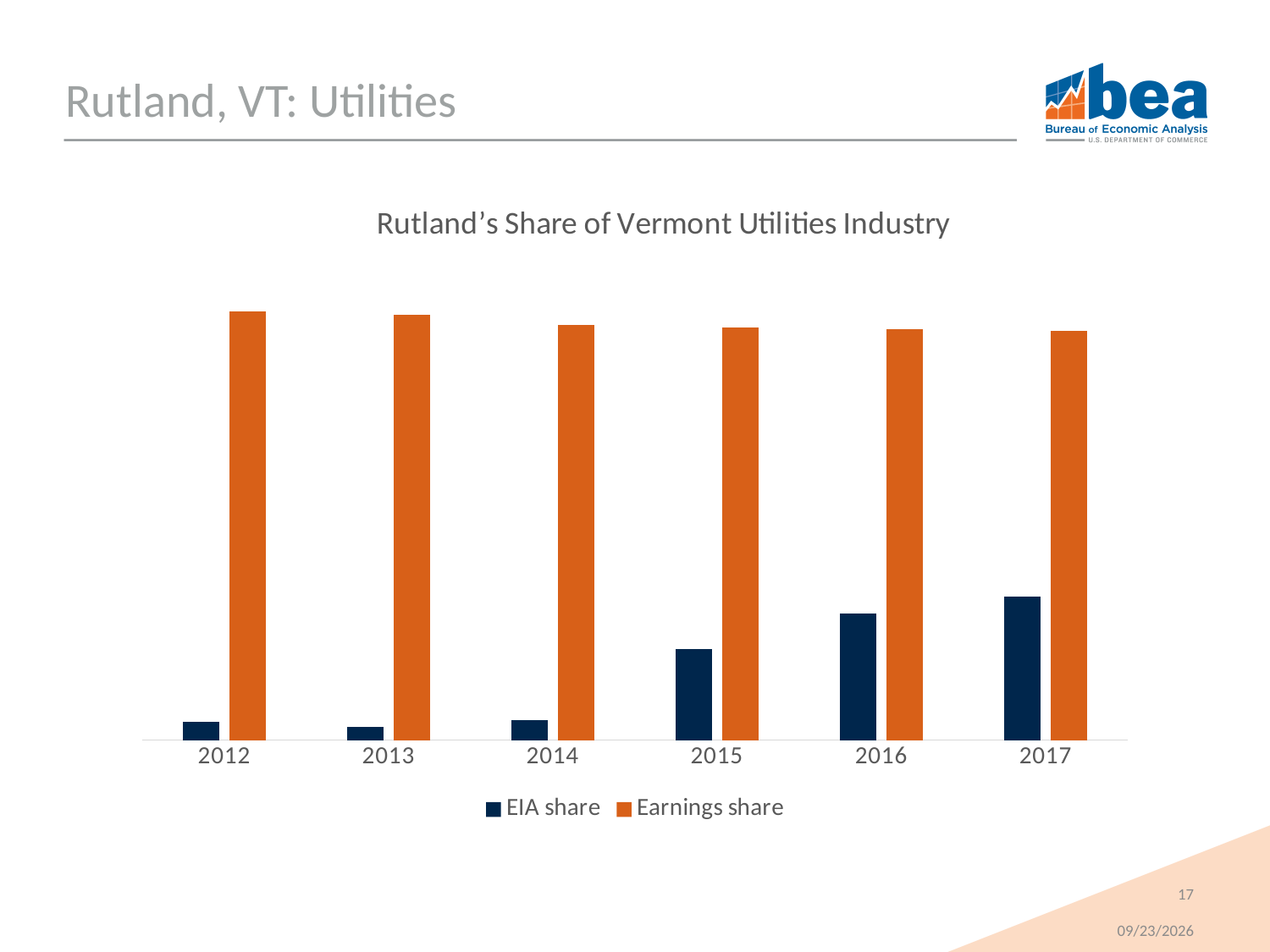
Does the Earnings share generally rise or fall from 2012 to 2017? fall Which year has the larger EIA share, 2012 or 2015? 2015 Which is larger in 2017, the EIA share or the Earnings share? Earnings share Which series is shown in orange? Earnings share In which year is the EIA share highest? 2017 What is the title of the chart? Rutland's Share of Vermont Utilities Industry Does the EIA share rise or fall from 2014 to 2017? rise How many series does the legend list? 2 Which year has the larger Earnings share, 2012 or 2017? 2012 What kind of chart is shown on the slide? bar chart How many years are shown on the x axis? 6